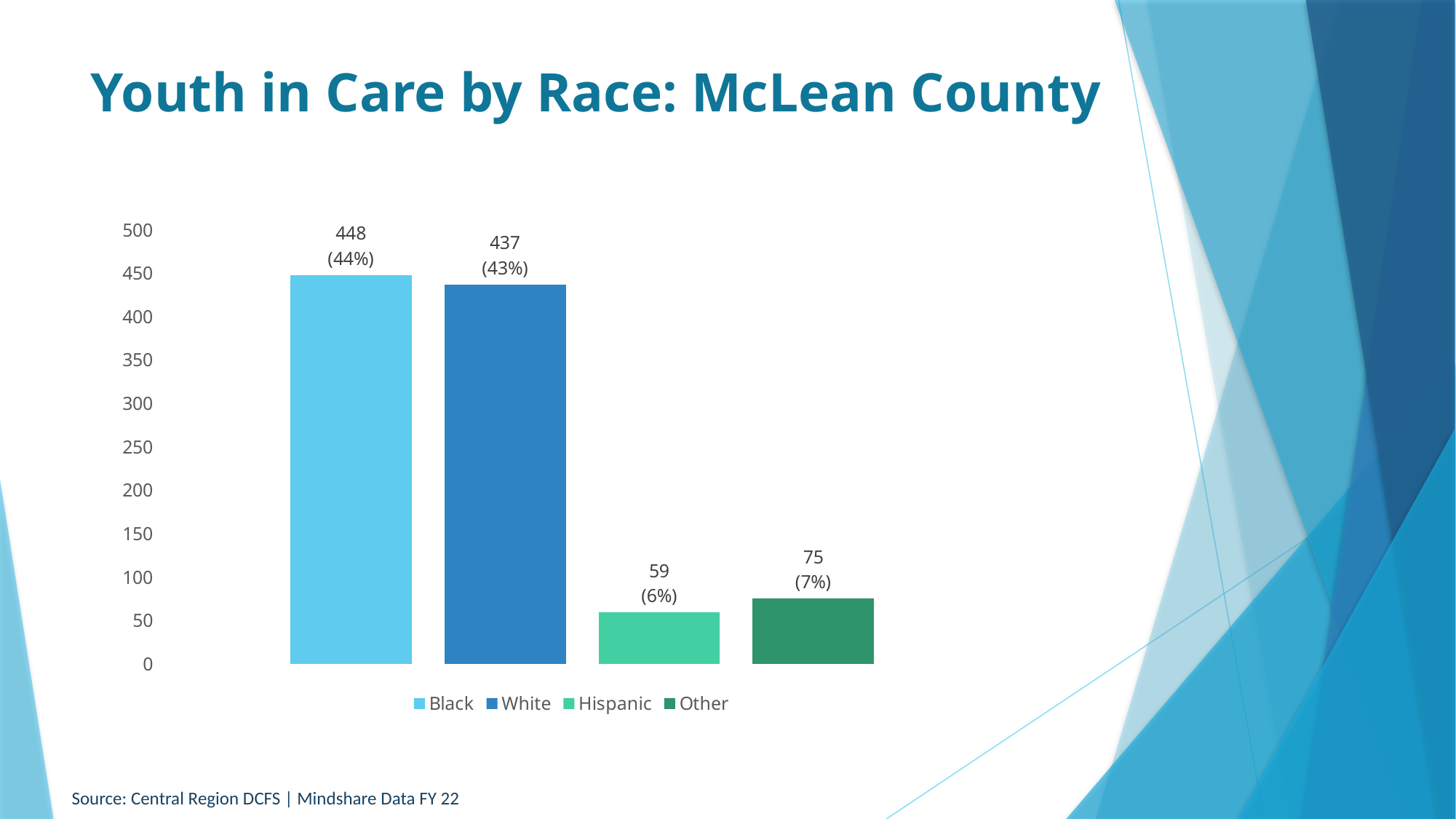
What kind of chart is shown on the slide? Bar chart Which category has the highest number of youth in care? Black How many categories are shown in the chart? 4 What is the number of youth in care for Hispanic youth? 59 Which is larger, the value for Other or the value for Hispanic? Other What is the title of the chart? Youth in Care by Race: McLean County Which category has the lowest number of youth in care? Hispanic What is the difference between the Other and Hispanic values? 16 What is the difference between the Black and White values? 11 Is the value for White greater or less than 400? greater What percentage is shown for the Other category? 7% What is the number of youth in care for Black youth? 448